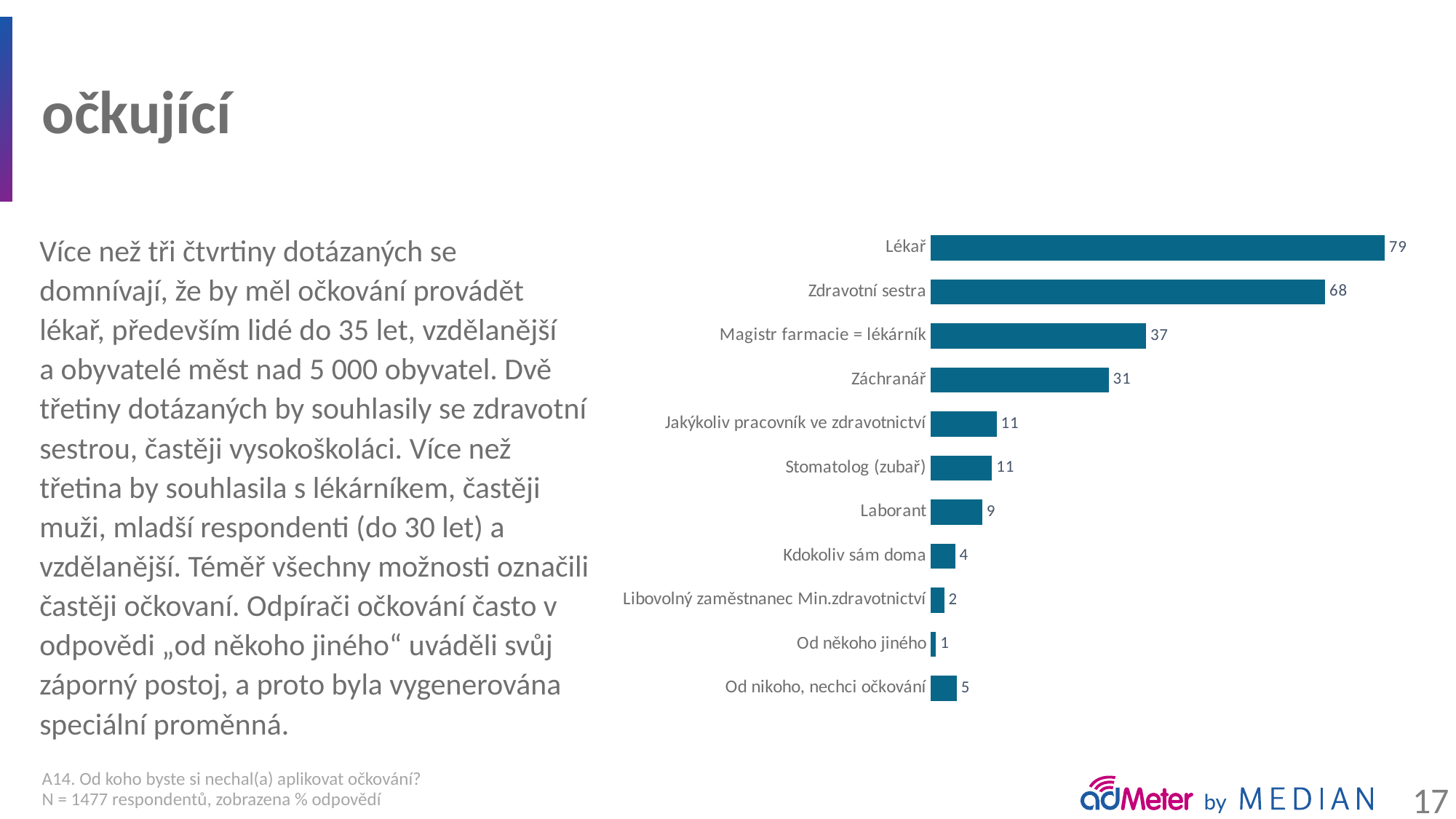
What is the value for Od nikoho, nechci očkování? 5 What is the value for Zdravotní sestra? 68 What is the value for Záchranář? 31 What kind of chart is shown on the slide? Bar chart What is the value for Magistr farmacie = lékárník? 37 Which is larger, the value for Laborant or the value for Kdokoliv sám doma? Laborant Which category has the highest value? Lékař What is the value for Lékař? 79 What is the difference between the values for Lékař and Zdravotní sestra? 11 What is the difference between the values for Magistr farmacie = lékárník and Záchranář? 6 How many categories are shown in the chart? 11 Which category has the lowest value? Od někoho jiného